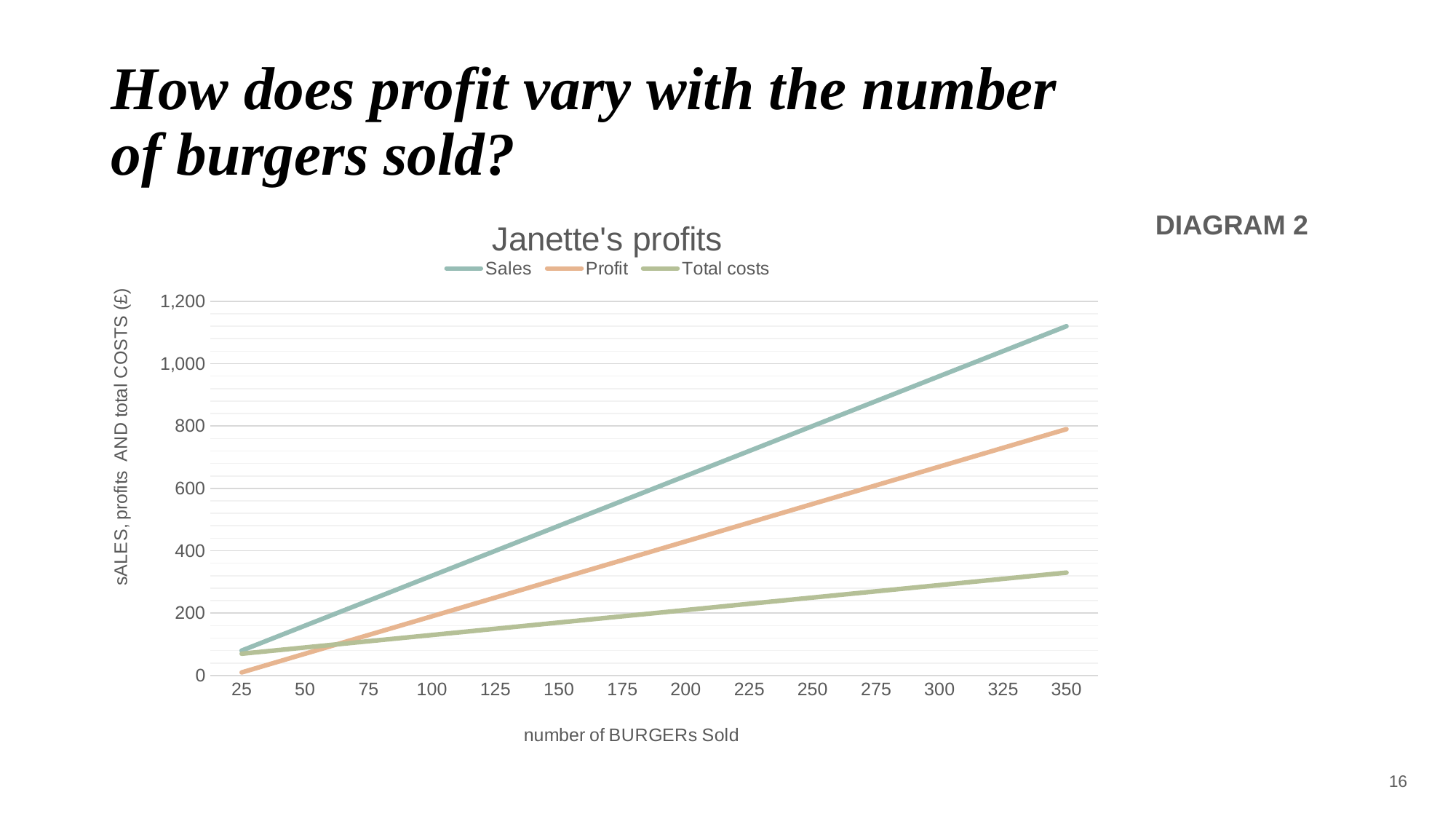
What is the title of the chart? Janette's profits What is the label of the x axis? number of BURGERs Sold Does the Total costs line rise or fall as the number of burgers sold increases? rise Does the Profit line rise or fall as the number of burgers sold increases? rise How many series does the legend list? 3 At 25 burgers sold, which is larger, Total costs or Profit? Total costs At 350 burgers sold, which is larger, Sales or Profit? Sales What kind of chart is shown on the slide? line chart Is the value for Sales at 350 burgers greater or less than 1,000? greater Is the value for Profit at 25 burgers greater or less than 200? less Is the value for Total costs at 350 burgers greater or less than 400? less How many points are marked along the x axis? 14